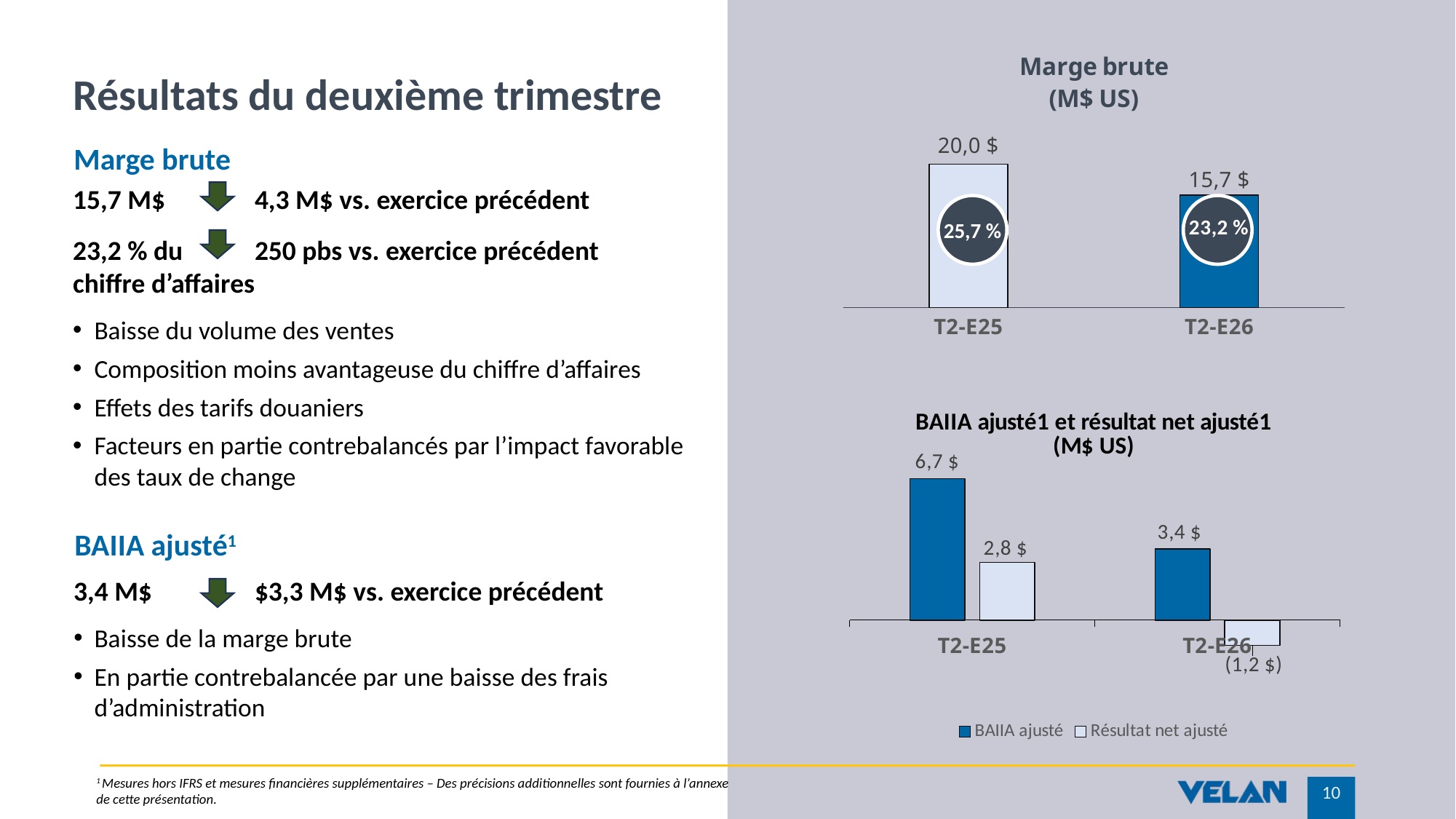
In the 'Marge brute' chart, what is the value for T2-E25? 20,0 $ In the 'Marge brute' chart, do the values rise or fall from T2-E25 to T2-E26? fall In the 'BAIIA ajusté et résultat net ajusté' chart, what is the Résultat net ajusté value for T2-E26? (1,2 $) In the 'Marge brute' chart, which period has the higher gross margin? T2-E25 In the 'Marge brute' chart, what is the value for T2-E26? 15,7 $ What type of chart is the 'BAIIA ajusté et résultat net ajusté' chart? bar chart In the 'BAIIA ajusté et résultat net ajusté' chart, how many series does the legend list? 2 In the 'BAIIA ajusté et résultat net ajusté' chart, what is the difference in BAIIA ajusté between T2-E25 and T2-E26? 3,3 $ In the 'Marge brute' chart, what percentage is shown inside the T2-E26 bar? 23,2 % In the 'Marge brute' chart, what is the difference between the T2-E25 and T2-E26 values? 4,3 $ In the 'BAIIA ajusté et résultat net ajusté' chart, what is the Résultat net ajusté value for T2-E25? 2,8 $ In the 'BAIIA ajusté et résultat net ajusté' chart, what is the BAIIA ajusté value for T2-E25? 6,7 $